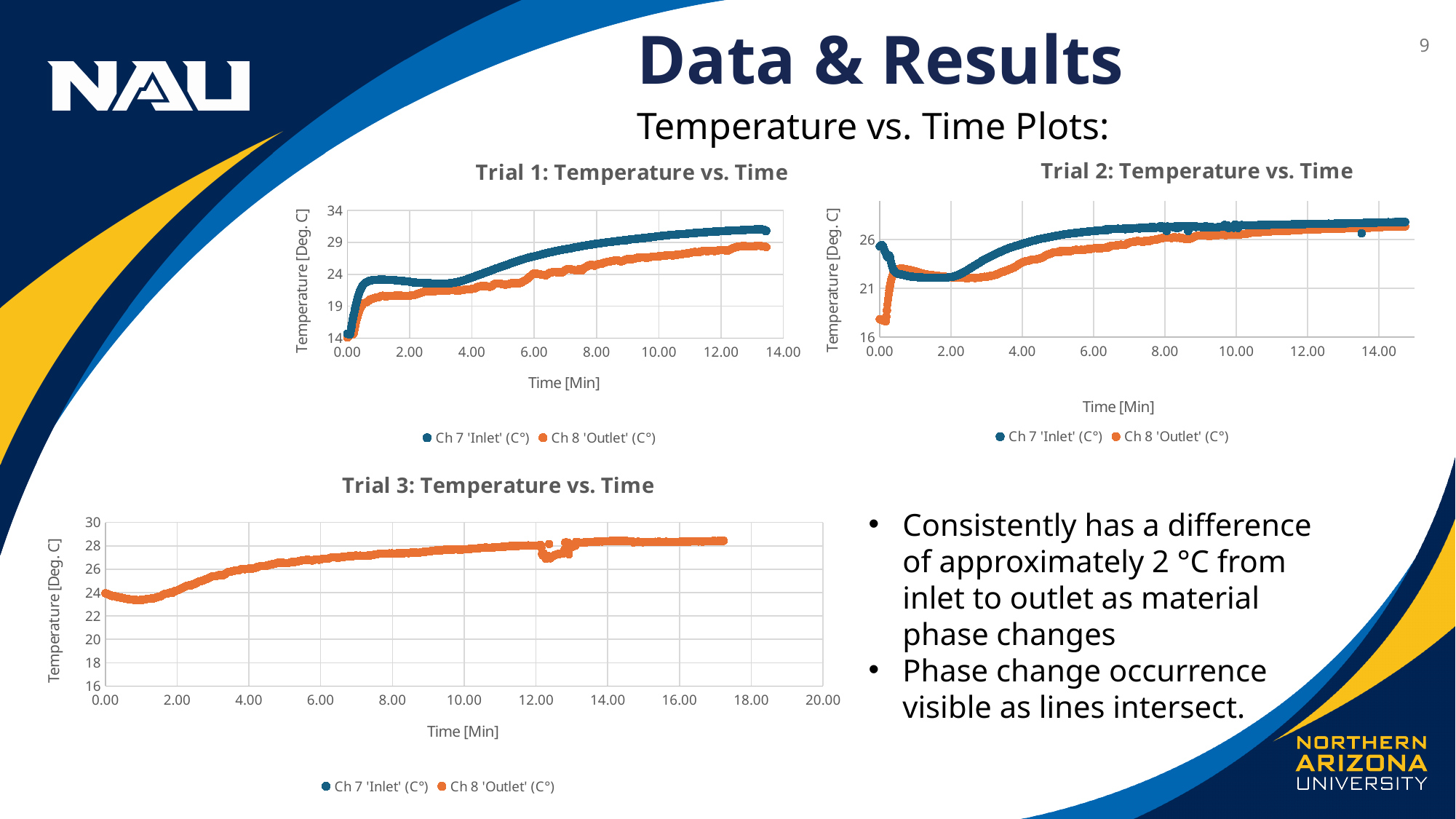
In the Trial 3: Temperature vs. Time chart, does the temperature overall rise or fall from 2.00 to 16.00 minutes? rise In the Trial 1: Temperature vs. Time chart, is the Ch 8 'Outlet' value at 12.00 minutes greater or less than 29? less How many series does the legend of the Trial 2: Temperature vs. Time chart list? 2 In the Trial 3: Temperature vs. Time chart, is the Ch 8 'Outlet' value at 10.00 minutes greater or less than 26? greater In the Trial 2: Temperature vs. Time chart, is the Ch 8 'Outlet' value at 6.00 minutes greater or less than 26? less Which colour represents Ch 8 'Outlet' (C°) in the legend of the Trial 1: Temperature vs. Time chart? orange What kind of chart is the Trial 1: Temperature vs. Time chart? scatter chart In the Trial 2: Temperature vs. Time chart, does the Ch 7 'Inlet' temperature overall rise or fall between 2.00 and 14.00 minutes? rise In the Trial 1: Temperature vs. Time chart, which series has the higher temperature at 10.00 minutes, Ch 7 'Inlet' or Ch 8 'Outlet'? Ch 7 'Inlet' (C°) What is the label of the x axis on the Trial 3: Temperature vs. Time chart? Time [Min]